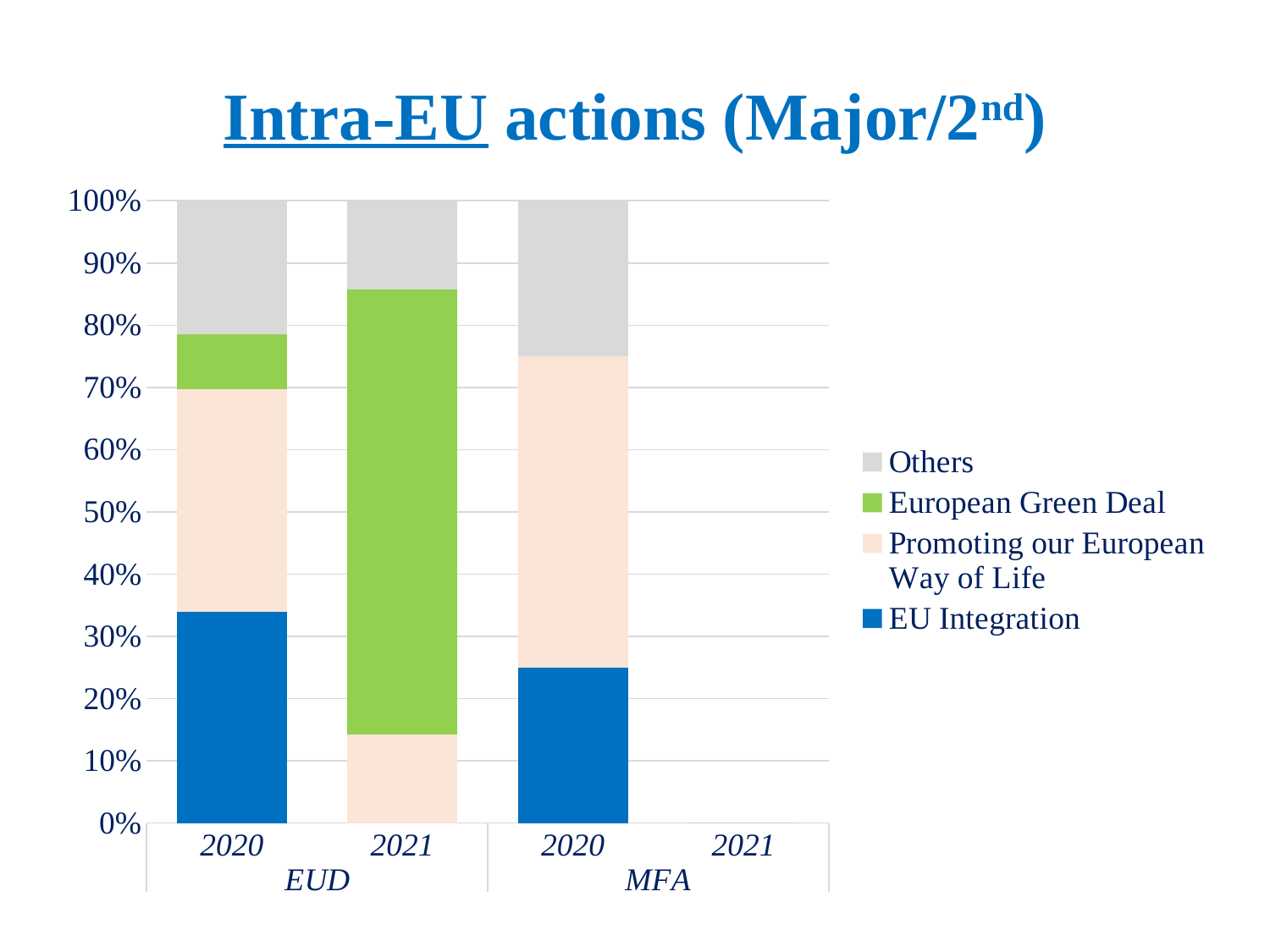
What is the title of the chart slide? Intra-EU actions (Major/2nd) Which has the larger EU Integration share, EUD 2020 or MFA 2020? EUD 2020 Is the European Green Deal share for EUD 2021 greater or less than 50%? greater Which bar has the largest European Green Deal segment? EUD 2021 Is the EU Integration share for MFA 2020 greater or less than 30%? less What kind of chart is shown on the slide? Stacked bar chart Which category on the x axis has no bar plotted? MFA 2021 How many series does the legend list? 4 Is the EU Integration share for EUD 2020 greater or less than 30%? greater Which series is shown in grey in the legend? Others Which has the larger European Green Deal share, EUD 2020 or EUD 2021? EUD 2021